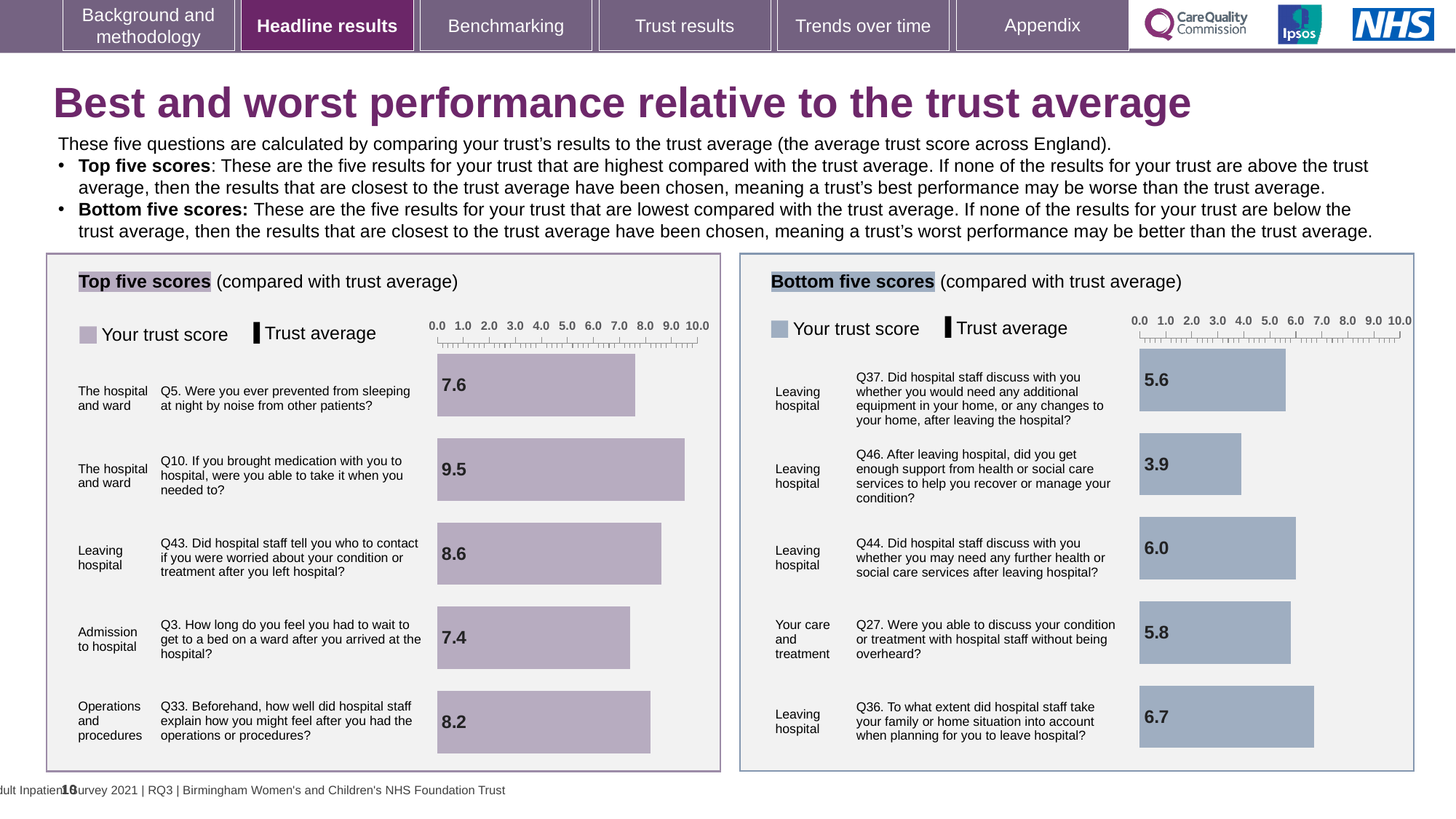
In the Bottom five scores chart, what is the difference between the trust scores for Q36 and Q46? 2.8 In the Bottom five scores chart, which question has the lowest trust score? Q46 In the Bottom five scores chart, what is the trust score for Q36 (To what extent did hospital staff take your family or home situation into account when planning for you to leave hospital?)? 6.7 In the Bottom five scores chart, which has the larger trust score, Q37 or Q27? Q27 In the Top five scores chart, what is the trust score for Q43 (Did hospital staff tell you who to contact if you were worried about your condition or treatment after you left hospital?)? 8.6 How many questions are shown in the Bottom five scores chart? 5 In the Top five scores chart, what is the trust score for Q10 (If you brought medication with you to hospital, were you able to take it when you needed to?)? 9.5 In the Bottom five scores chart, what is the trust score for Q46 (After leaving hospital, did you get enough support from health or social care services)? 3.9 What type of chart is used in the Top five scores panel? Bar chart In the Top five scores chart, which question has the highest trust score? Q10 In the Top five scores chart, what is the difference between the trust scores for Q10 and Q5? 1.9 In the Top five scores chart, which question has the lowest trust score? Q3